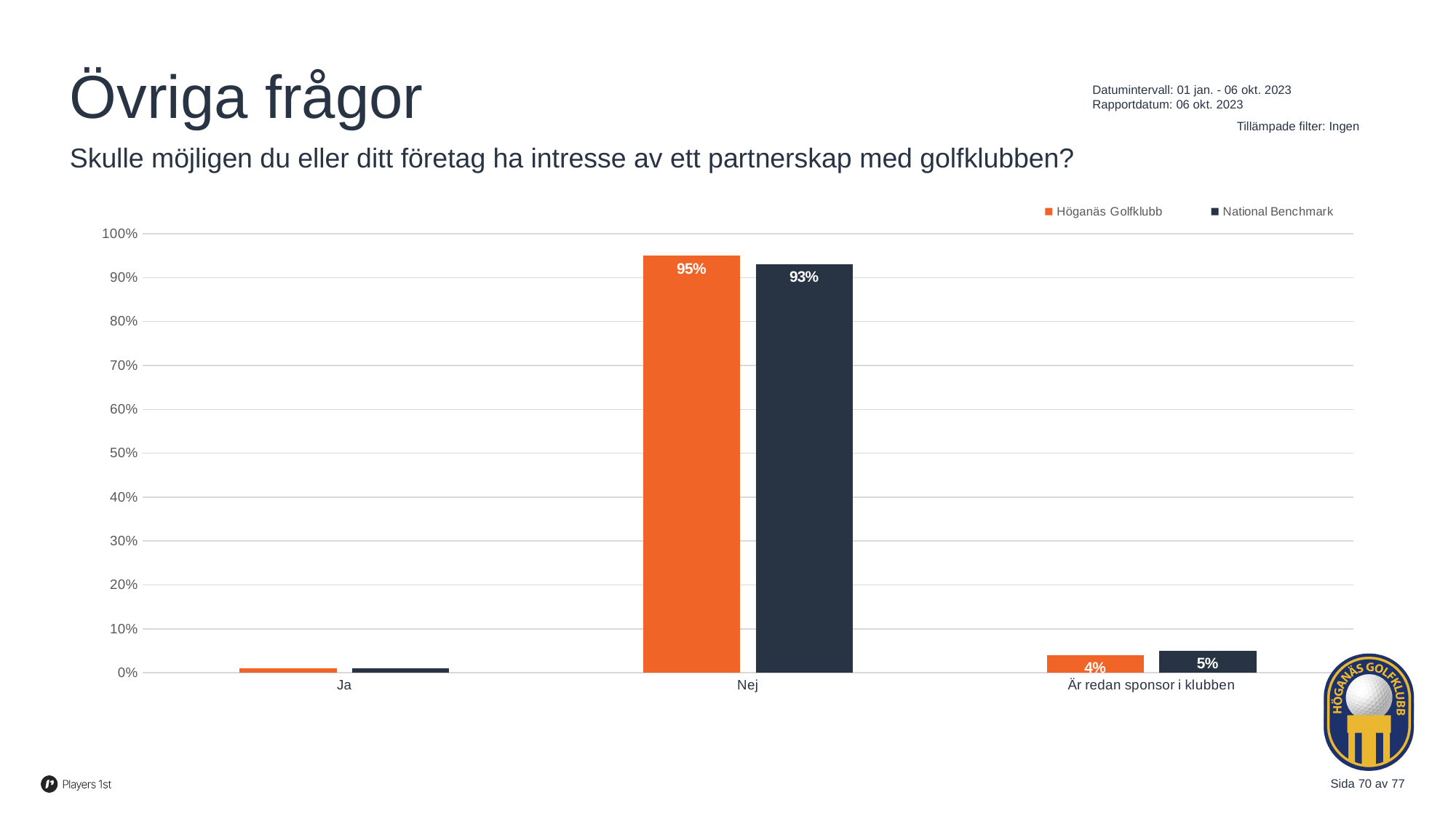
What is the value for National Benchmark in the Nej category? 93% What is the value for National Benchmark in the 'Är redan sponsor i klubben' category? 5% What is the difference between Höganäs Golfklubb and National Benchmark in the Nej category? 2% Is the value for Höganäs Golfklubb in the Ja category greater or less than 10%? less How many series does the legend list? 2 How many categories are shown on the x axis? 3 What kind of chart is shown on the slide? Bar chart Which category has the lowest value for National Benchmark? Ja What is the value for Höganäs Golfklubb in the 'Är redan sponsor i klubben' category? 4% What is the value for Höganäs Golfklubb in the Nej category? 95% Which category has the highest value for Höganäs Golfklubb? Nej In the 'Är redan sponsor i klubben' category, which series has the larger value? National Benchmark